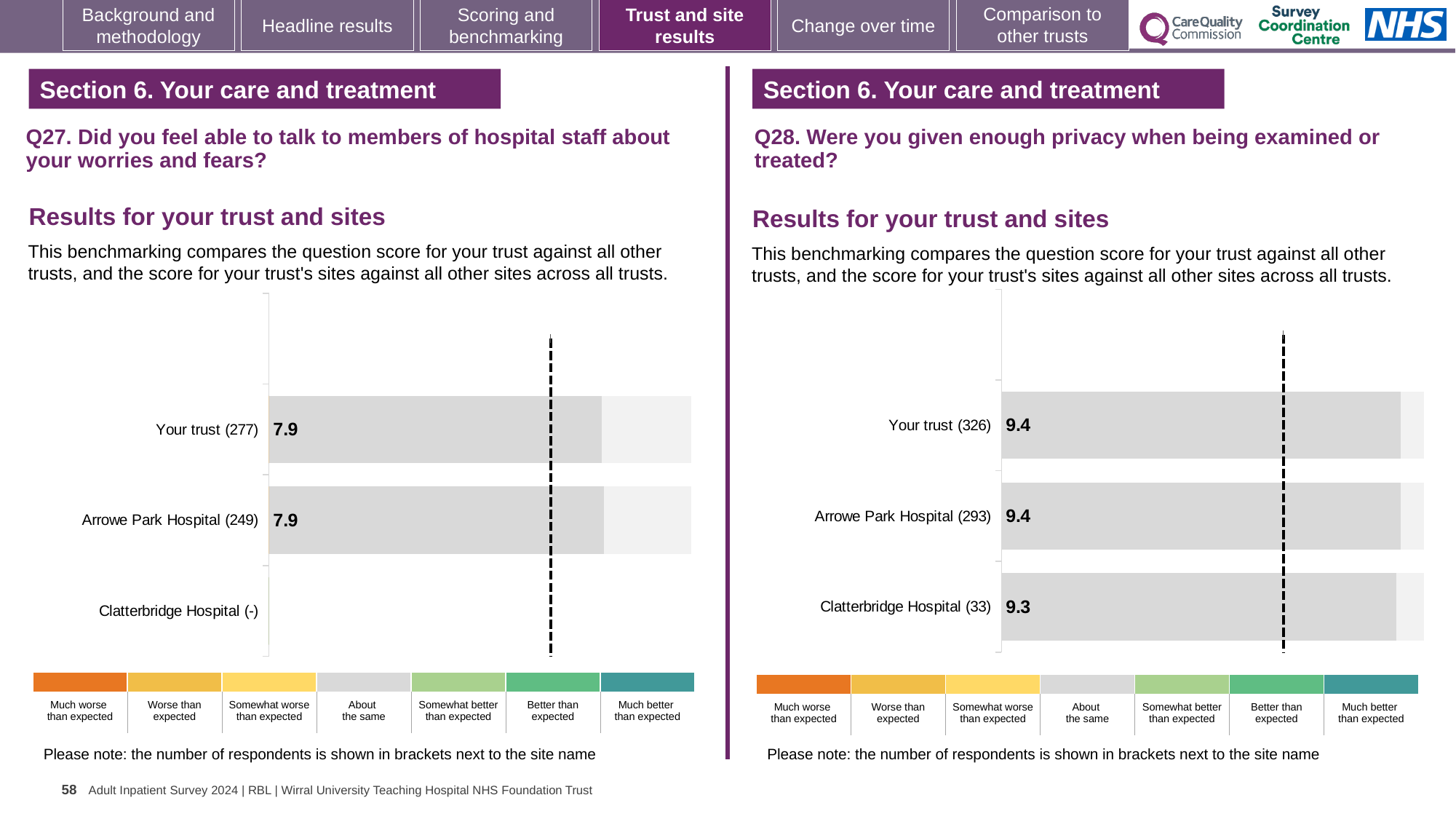
In the Q28 chart on the right, how many respondents are shown for Your trust? 326 How many categories does the colour key below the Q27 chart on the left list? 7 In the Q27 chart on the left, is a score shown for Clatterbridge Hospital? No In the Q28 chart on the right, what is the score for Your trust? 9.4 In the Q27 chart on the left, how many rows (trust and sites) are listed? 3 What kind of chart is used in the Q28 chart on the right? Bar chart In the Q28 chart on the right, which site has the lowest score? Clatterbridge Hospital In the Q27 chart on the left, what is the score for Arrowe Park Hospital? 7.9 In the Q27 chart on the left, how many respondents are shown for Arrowe Park Hospital? 249 In the Q28 chart on the right, what is the score for Clatterbridge Hospital? 9.3 In the Q28 chart on the right, what is the difference between the scores for Arrowe Park Hospital and Clatterbridge Hospital? 0.1 In the Q27 chart on the left, what is the score for Your trust? 7.9